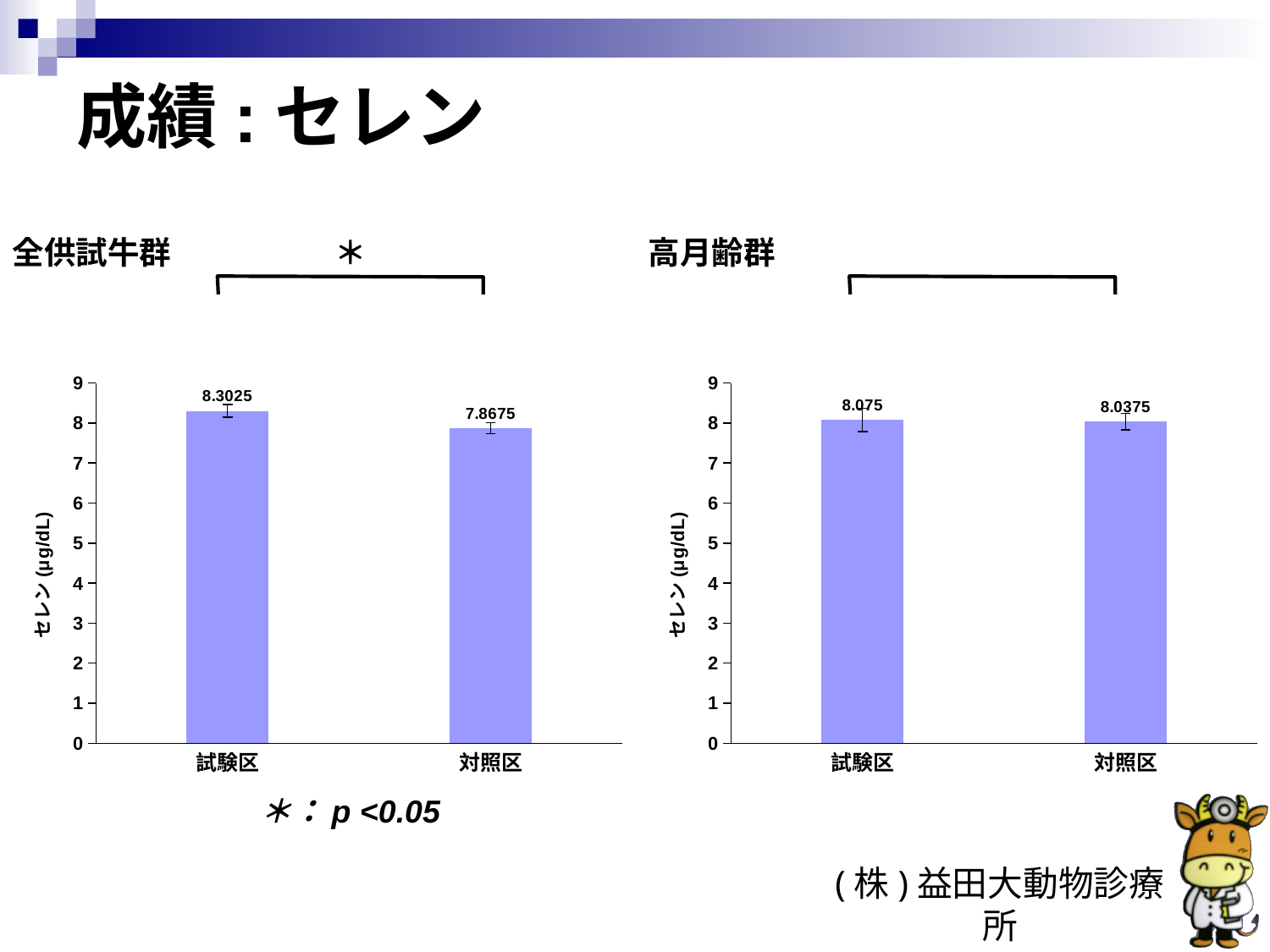
In the 全供試牛群 chart, is the value for 対照区 greater or less than 8? less In the 高月齢群 chart, which is larger, 試験区 or 対照区? 試験区 What kind of chart is the 全供試牛群 chart? bar chart In the 高月齢群 chart, what is the difference between 試験区 and 対照区? 0.0375 In the 全供試牛群 chart, what is the value for 試験区? 8.3025 In the 高月齢群 chart, what is the value for 対照区? 8.0375 What is the y-axis label of the 高月齢群 chart? セレン(μg/dL) In the 全供試牛群 chart, which category has the higher value? 試験区 In the 全供試牛群 chart, what is the difference between 試験区 and 対照区? 0.435 In the 高月齢群 chart, what is the value for 試験区? 8.075 How many categories are shown in the 高月齢群 chart? 2 In the 全供試牛群 chart, what is the value for 対照区? 7.8675